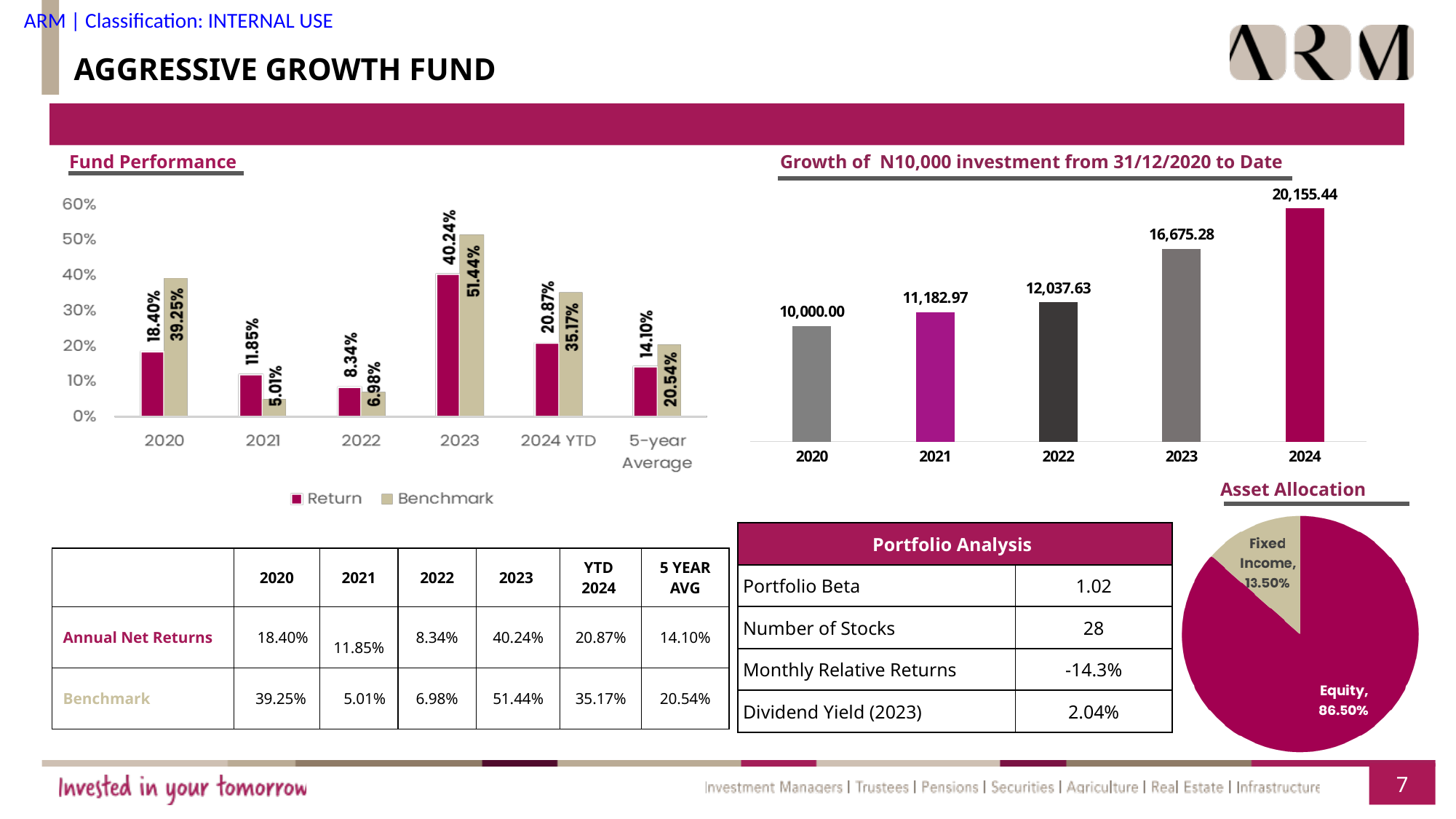
In the Fund Performance chart, which category has the lowest Return value? 2022 In the Growth of N10,000 investment chart, what is the difference between the 2024 and 2020 values? 10,155.44 In the Growth of N10,000 investment chart, do the values rise or fall from 2020 to 2024? rise In the Asset Allocation pie chart, what share is Fixed Income? 13.50% How many bars are in the Growth of N10,000 investment chart? 5 In the Fund Performance chart, what is the difference between the Benchmark and Return values for 2020? 20.85% In the Growth of N10,000 investment chart, what is the value for 2023? 16,675.28 How many series does the legend of the Fund Performance chart list? 2 In the Fund Performance chart, which is larger for 2022, the Return or the Benchmark? Return In the Fund Performance chart, what is the Benchmark value for 2021? 5.01% In the Fund Performance chart, what is the Return value for 2023? 40.24% In the Fund Performance chart, which year has the highest Benchmark value? 2023